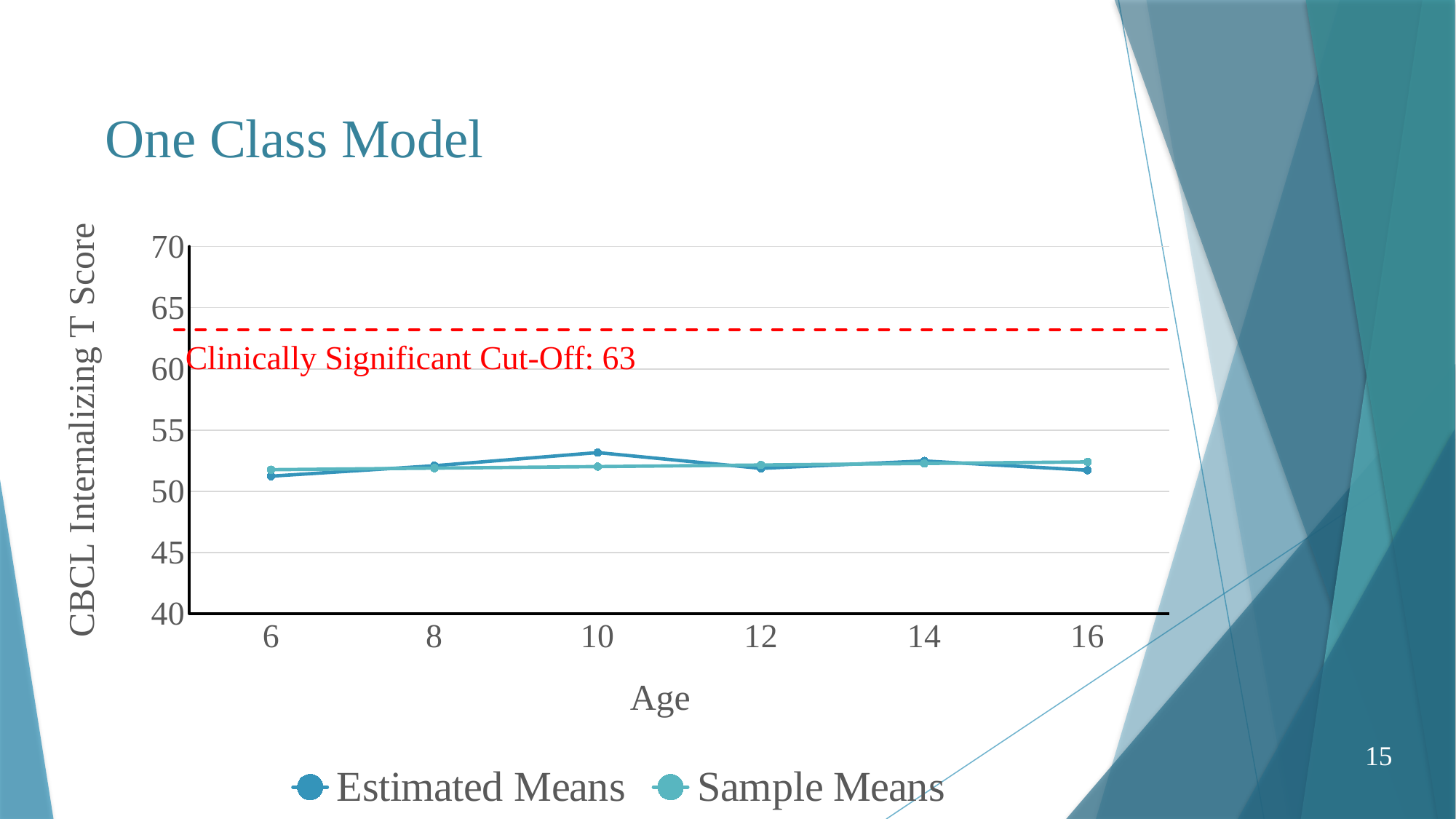
Is the Sample Means value at age 6 greater or less than 50? greater Is the Estimated Means value at age 10 greater or less than 55? less At age 10, which series has the larger value, Estimated Means or Sample Means? Estimated Means Is the Estimated Means value at age 14 greater or less than 60? less What is the title of the y axis? CBCL Internalizing T Score What kind of chart is shown on the slide? line chart At which age is the Estimated Means value highest? 10 At age 16, which series has the larger value, Estimated Means or Sample Means? Sample Means How many series does the legend list? 2 What value is the Clinically Significant Cut-Off line drawn at? 63 How many age points are plotted along the x axis? 6